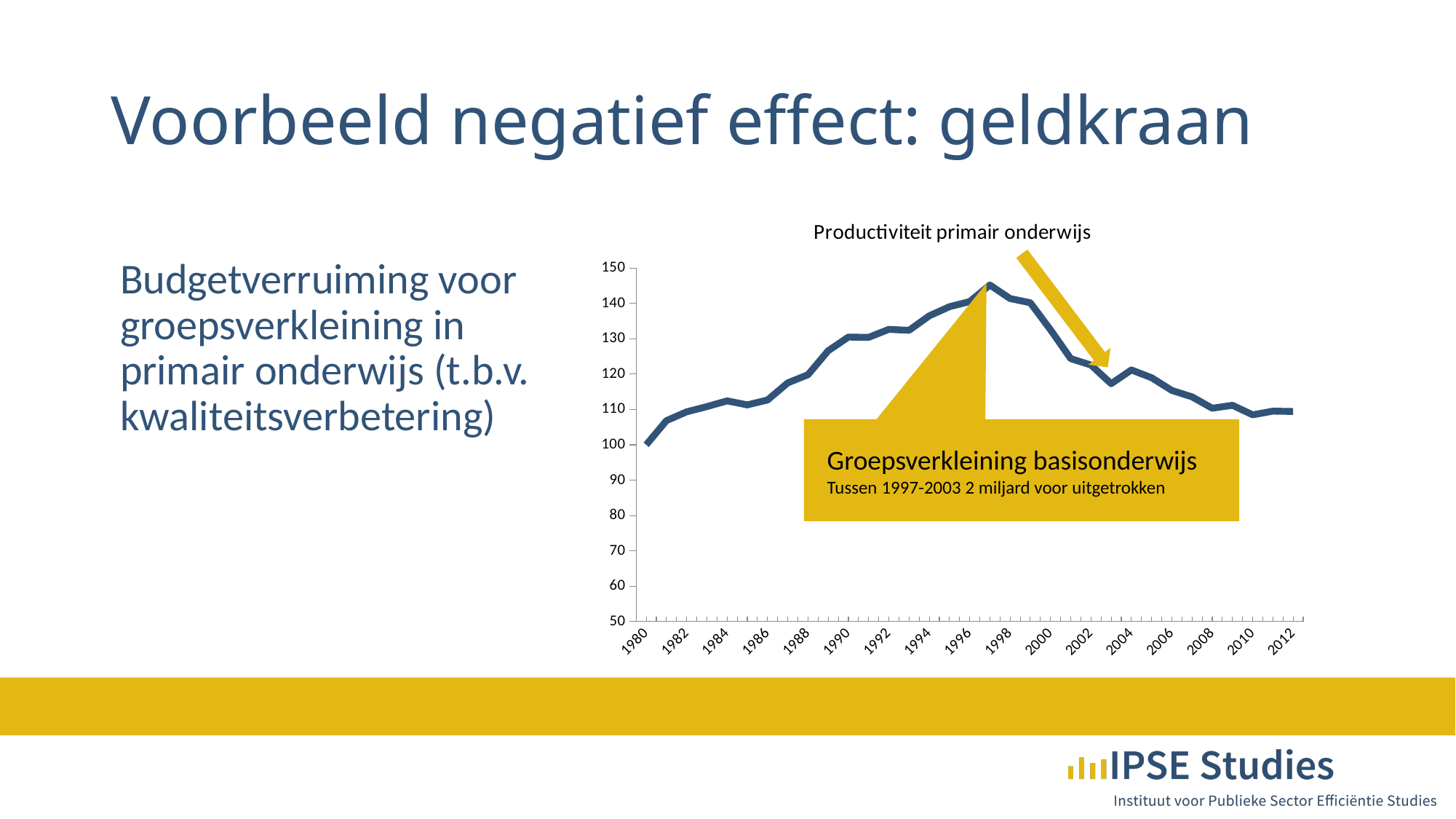
In which year is the productivity line at its lowest point? 1980 Is the value for 2012 greater or less than 120? less Is the value for 1997 greater or less than 140? greater What is the title of the chart? Productiviteit primair onderwijs What kind of chart is shown on the slide? line chart Does the productivity line rise or fall between 1997 and 2012? fall What is the value of the productivity index in 1980? 100 Does the productivity line rise or fall between 1980 and 1997? rise In which year does the productivity line reach its highest point? 1997 Is the value for 1990 greater or less than 120? greater What does the yellow callout box on the chart say in its heading? Groepsverkleining basisonderwijs Which year has the higher productivity value, 1990 or 2010? 1990